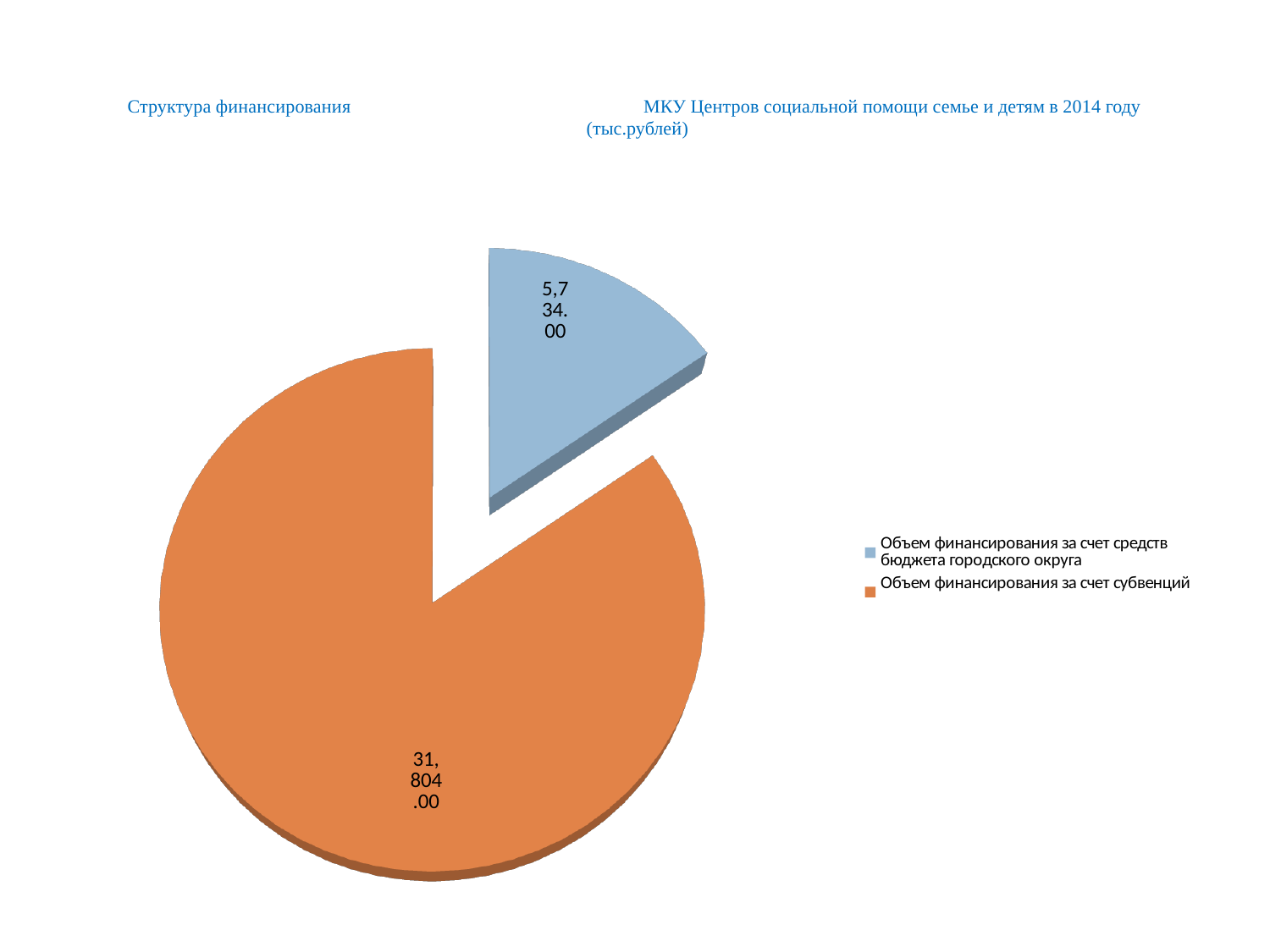
Which category has the largest slice of the pie? Объем финансирования за счет субвенций How many entries does the legend list? 2 What is the value for "Объем финансирования за счет средств бюджета городского округа"? 5,734.00 Which is larger: the value for "Объем финансирования за счет субвенций" or the value for "Объем финансирования за счет средств бюджета городского округа"? Объем финансирования за счет субвенций How many slices does the pie chart have? 2 What kind of chart is shown on the slide? Pie chart What is the difference between the value for "Объем финансирования за счет субвенций" and the value for "Объем финансирования за счет средств бюджета городского округа"? 26,070.00 What is the value for "Объем финансирования за счет субвенций"? 31,804.00 What is the total of the two values shown in the pie chart? 37,538.00 In what unit are the values in the chart expressed, according to the title? тыс.рублей Which category has the smallest slice of the pie? Объем финансирования за счет средств бюджета городского округа What colour is the slice for "Объем финансирования за счет субвенций"? Orange